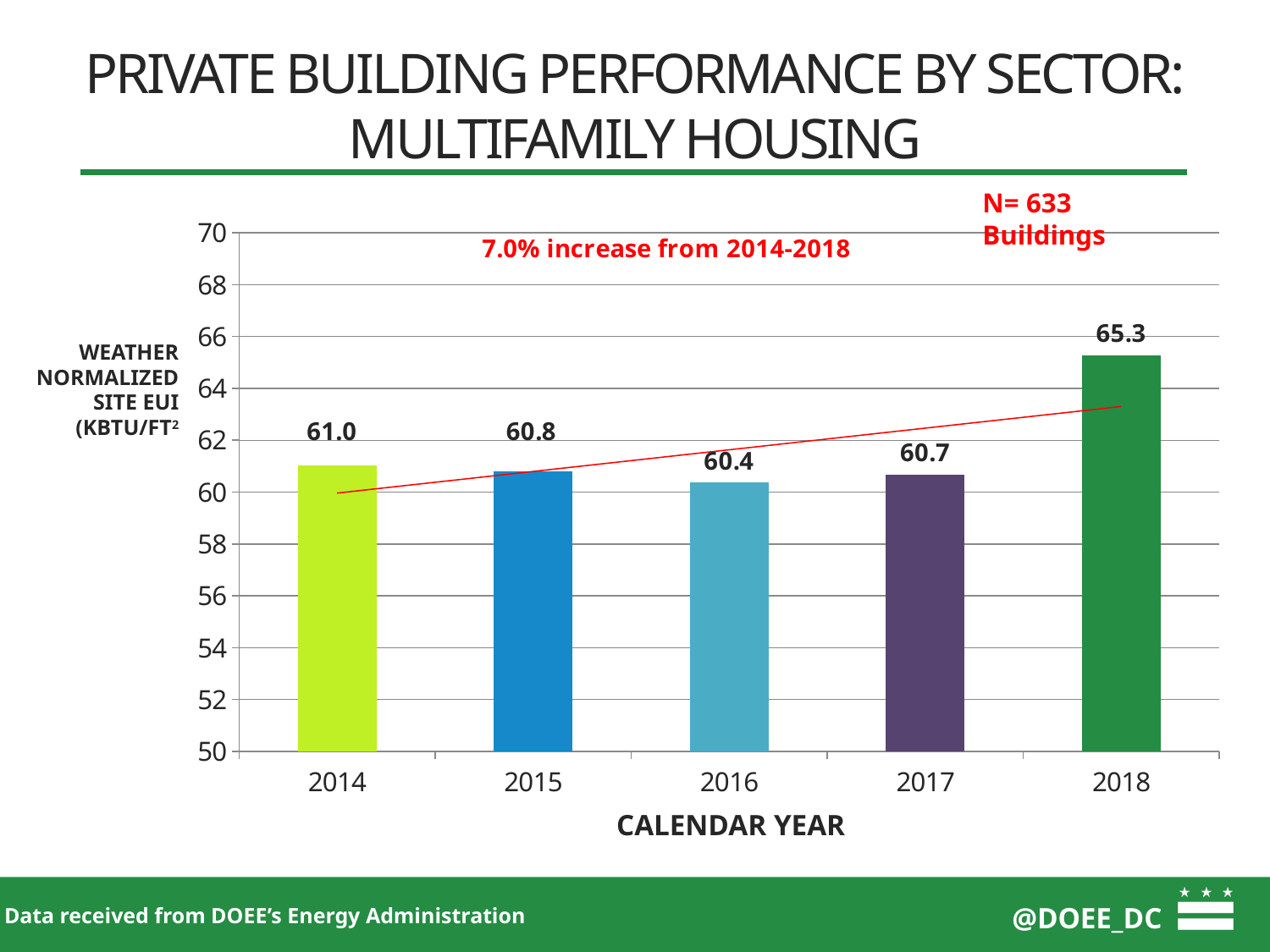
Which calendar year has the highest weather normalized site EUI? 2018 What kind of chart is shown on the slide? bar chart Which is larger, the value for 2015 or the value for 2017? 2015 What is the weather normalized site EUI value for 2018? 65.3 Which calendar year has the lowest weather normalized site EUI? 2016 What is the weather normalized site EUI value for 2014? 61.0 What is the value shown for 2016? 60.4 Is the value for 2018 greater or less than 64? greater What percentage increase from 2014-2018 is annotated on the chart? 7.0% How many calendar years are shown on the x axis? 5 How many buildings does the chart annotation say are included (N)? 633 What is the difference between the 2018 value and the 2014 value? 4.3